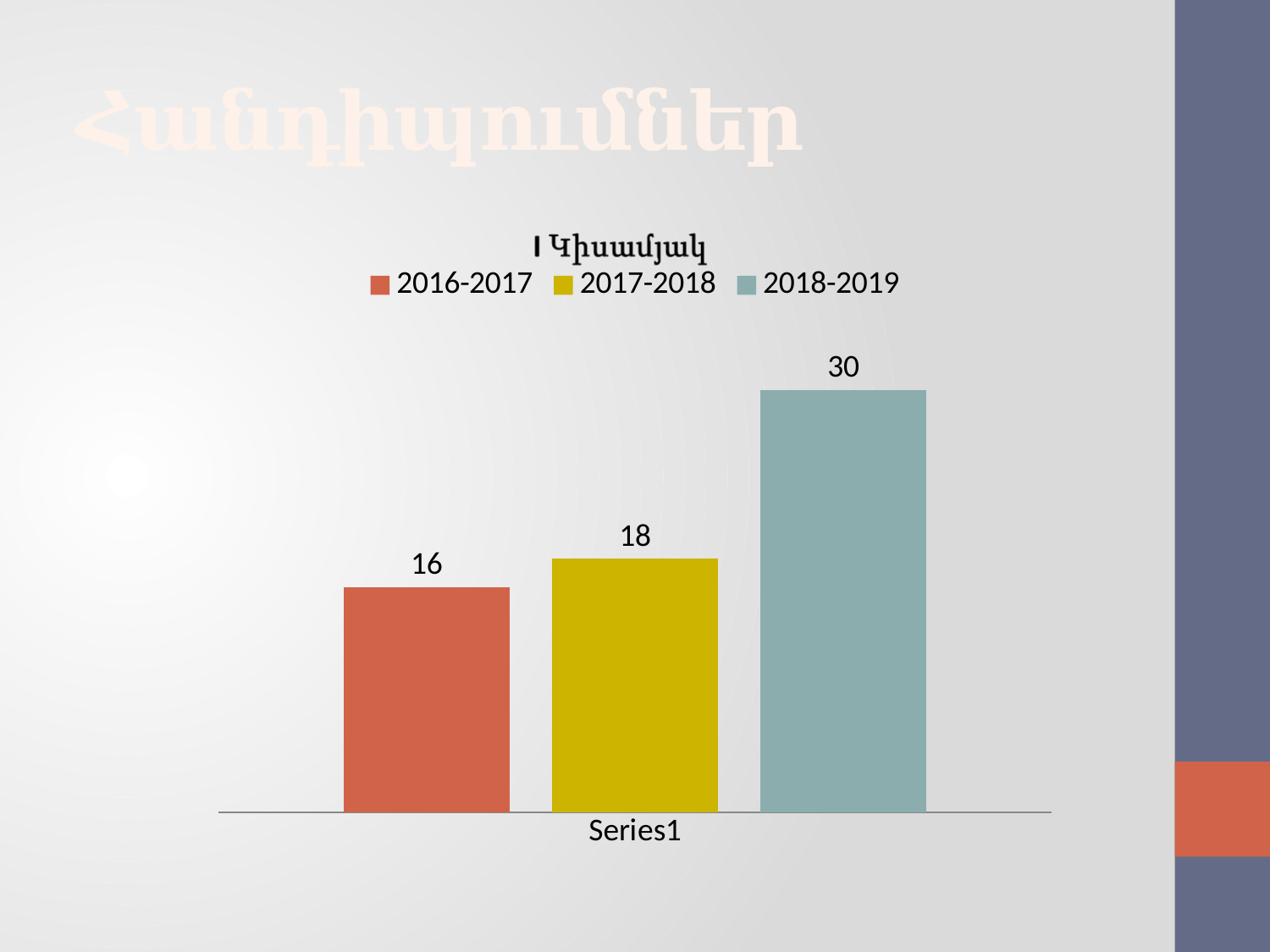
Which series has the lowest value? 2016-2017 What is the value for 2016-2017? 16 What kind of chart is shown on the slide? Bar chart What is the title of the chart? I Կիսամյակ Which series has the highest value? 2018-2019 What is the value for 2018-2019? 30 What is the value for 2017-2018? 18 Which is larger, the value for 2017-2018 or the value for 2018-2019? 2018-2019 What is the difference between the values for 2018-2019 and 2016-2017? 14 How many series does the legend list? 3 Do the values rise or fall from 2016-2017 to 2018-2019? Rise What is the difference between the values for 2017-2018 and 2016-2017? 2